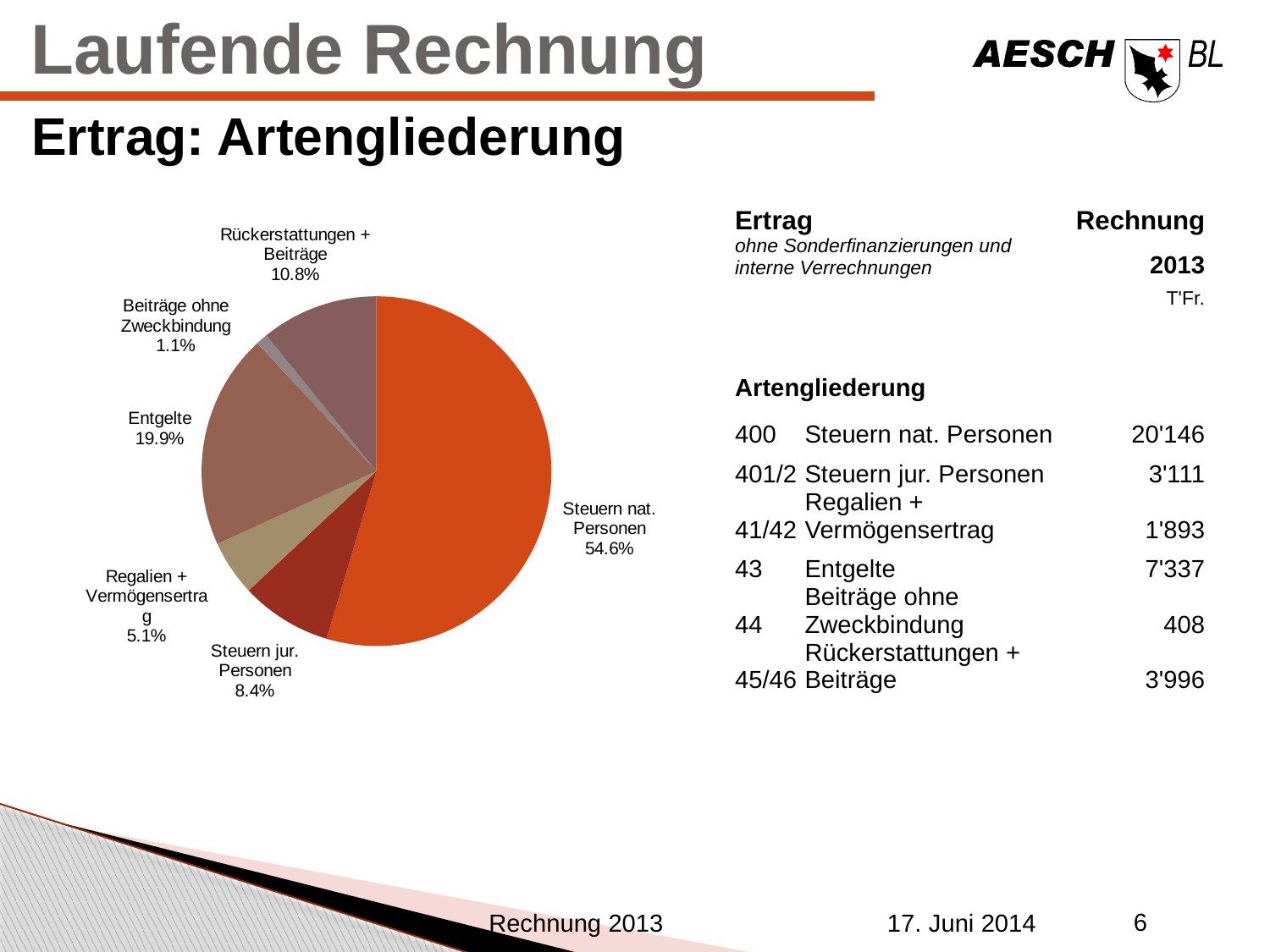
What is the title of the slide section containing the pie chart? Ertrag: Artengliederung Which slice of the pie chart is the largest? Steuern nat. Personen What share of the pie does Steuern nat. Personen represent? 54.6% What is the difference in percentage points between Entgelte and Steuern jur. Personen? 11.5 What is the percentage shown for Entgelte in the pie chart? 19.9% What is the difference in percentage points between Steuern nat. Personen and Entgelte? 34.7 How many slices does the pie chart have? 6 What kind of chart is shown on the slide? pie chart Which slice of the pie chart is the smallest? Beiträge ohne Zweckbindung What is the percentage shown for Steuern jur. Personen in the pie chart? 8.4% Which is larger in the pie chart, Rückerstattungen + Beiträge or Regalien + Vermögensertrag? Rückerstattungen + Beiträge What is the percentage shown for Rückerstattungen + Beiträge in the pie chart? 10.8%